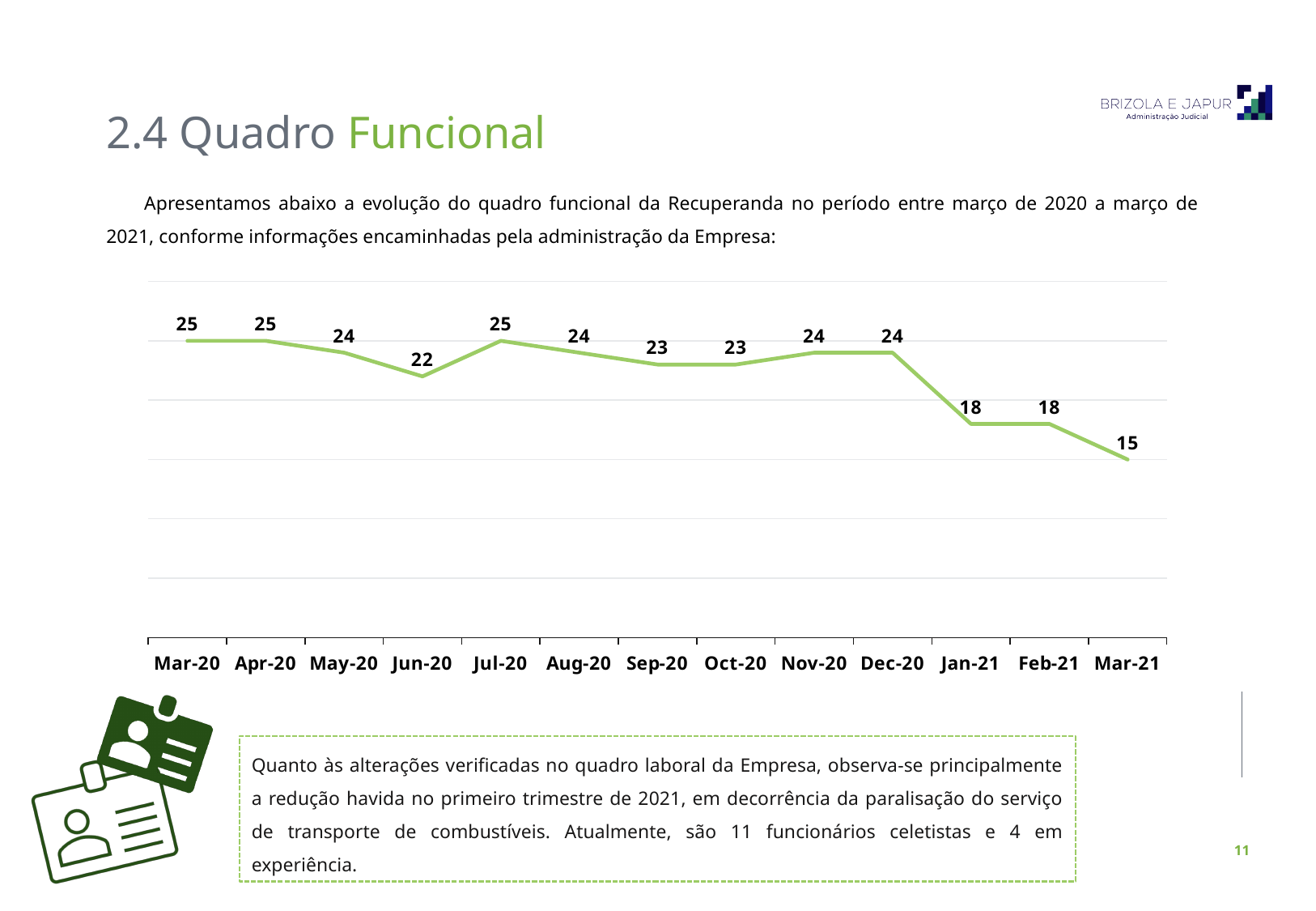
What is the difference between the values for Mar-20 and Mar-21? 10 What is the value for Jun-20? 22 What is the value for Mar-21? 15 Which is larger, the value for Jul-20 or the value for Jun-20? Jul-20 What is the highest value shown on the chart? 25 Which month has the lowest value? Mar-21 What kind of chart is shown on the slide? Line chart What is the difference between the values for Dec-20 and Jan-21? 6 Do the values generally rise or fall from Mar-20 to Mar-21? Fall What is the value for Sep-20? 23 What is the value for Jan-21? 18 How many months are plotted on the chart? 13